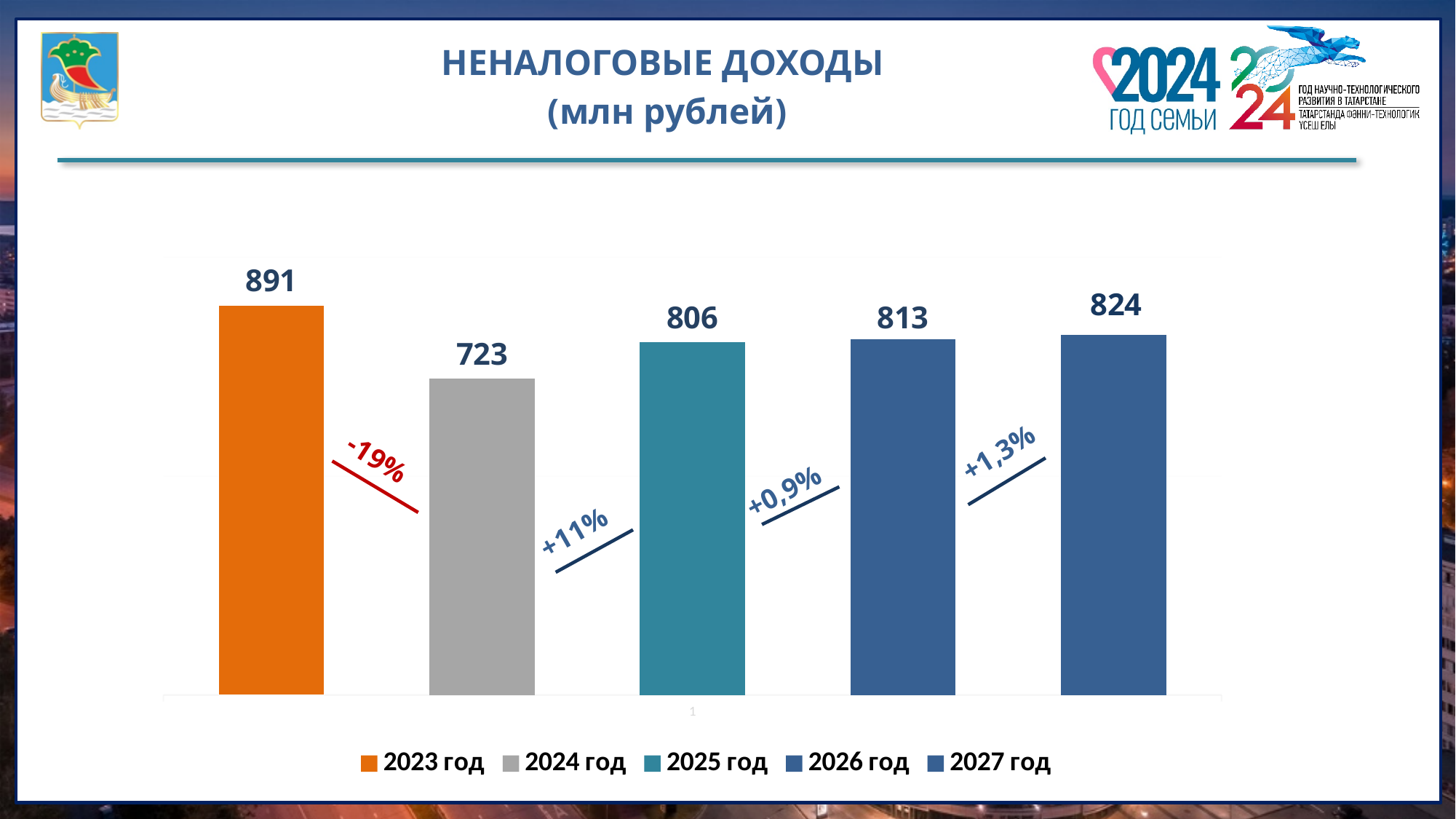
Which year has the lowest value? 2024 год What kind of chart is shown on the slide? Bar chart Which year has the highest value? 2023 год What is the value for 2025 год? 806 Which is larger, the value for 2025 год or the value for 2024 год? 2025 год What is the value for 2024 год? 723 What is the value for 2023 год? 891 What is the difference between the values for 2027 год and 2026 год? 11 What is the difference between the values for 2023 год and 2024 год? 168 How many series does the legend list? 5 What is the value for 2027 год? 824 What percentage change is shown between 2024 год and 2025 год? +11%